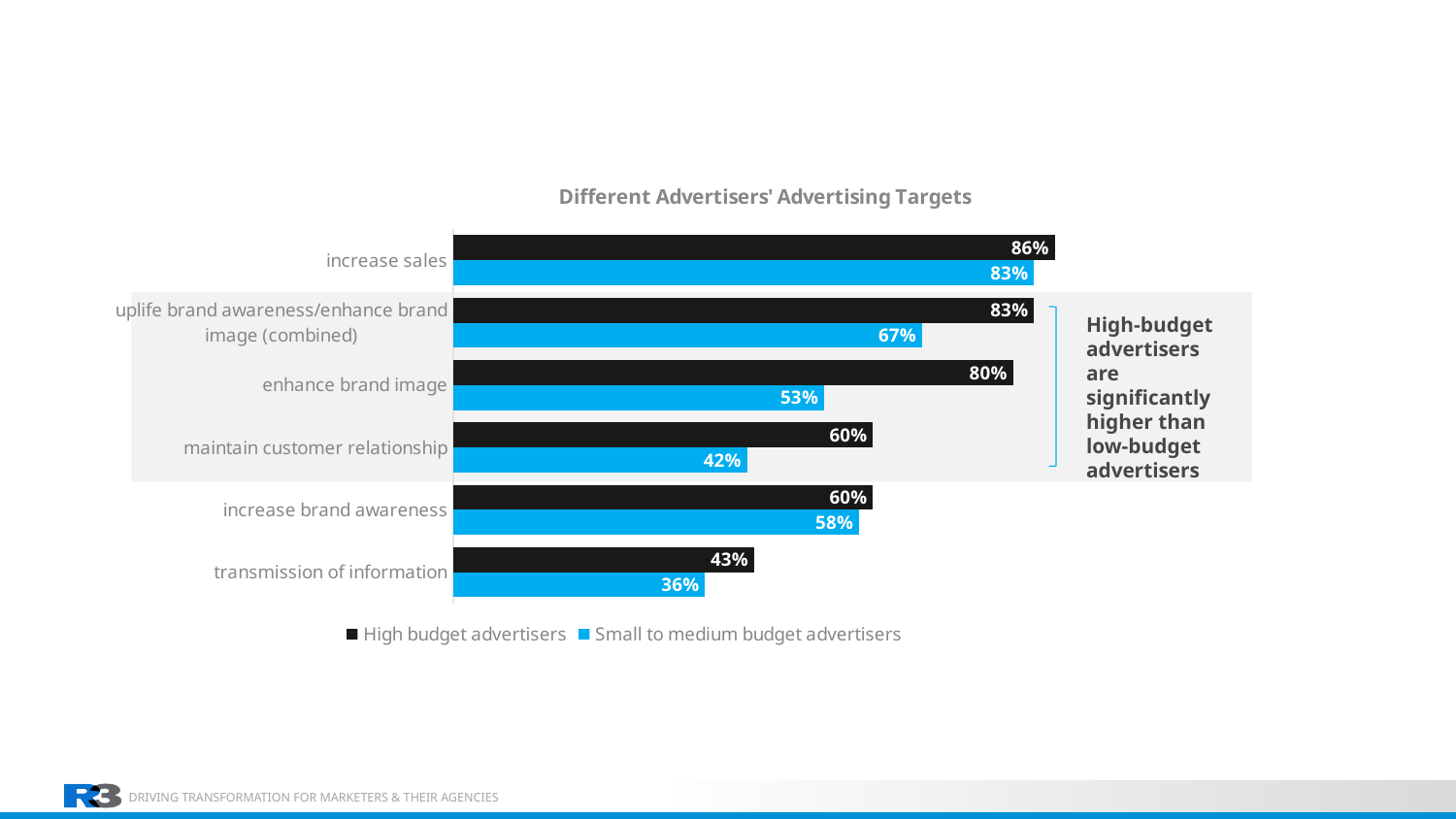
What is the title of the chart? Different Advertisers' Advertising Targets What is the value for Small to medium budget advertisers for 'maintain customer relationship'? 42% Which category has the highest value for High budget advertisers? increase sales Which category has the lowest value for Small to medium budget advertisers? transmission of information What kind of chart is shown on the slide? bar chart How many categories are shown on the chart? 6 For 'increase brand awareness', which series has the larger value: High budget advertisers or Small to medium budget advertisers? High budget advertisers What is the difference between High budget advertisers and Small to medium budget advertisers for 'transmission of information'? 7% What is the value for Small to medium budget advertisers for 'enhance brand image'? 53% What is the difference between High budget advertisers and Small to medium budget advertisers for 'enhance brand image'? 27% How many series does the legend list? 2 What is the value for High budget advertisers for 'increase sales'? 86%